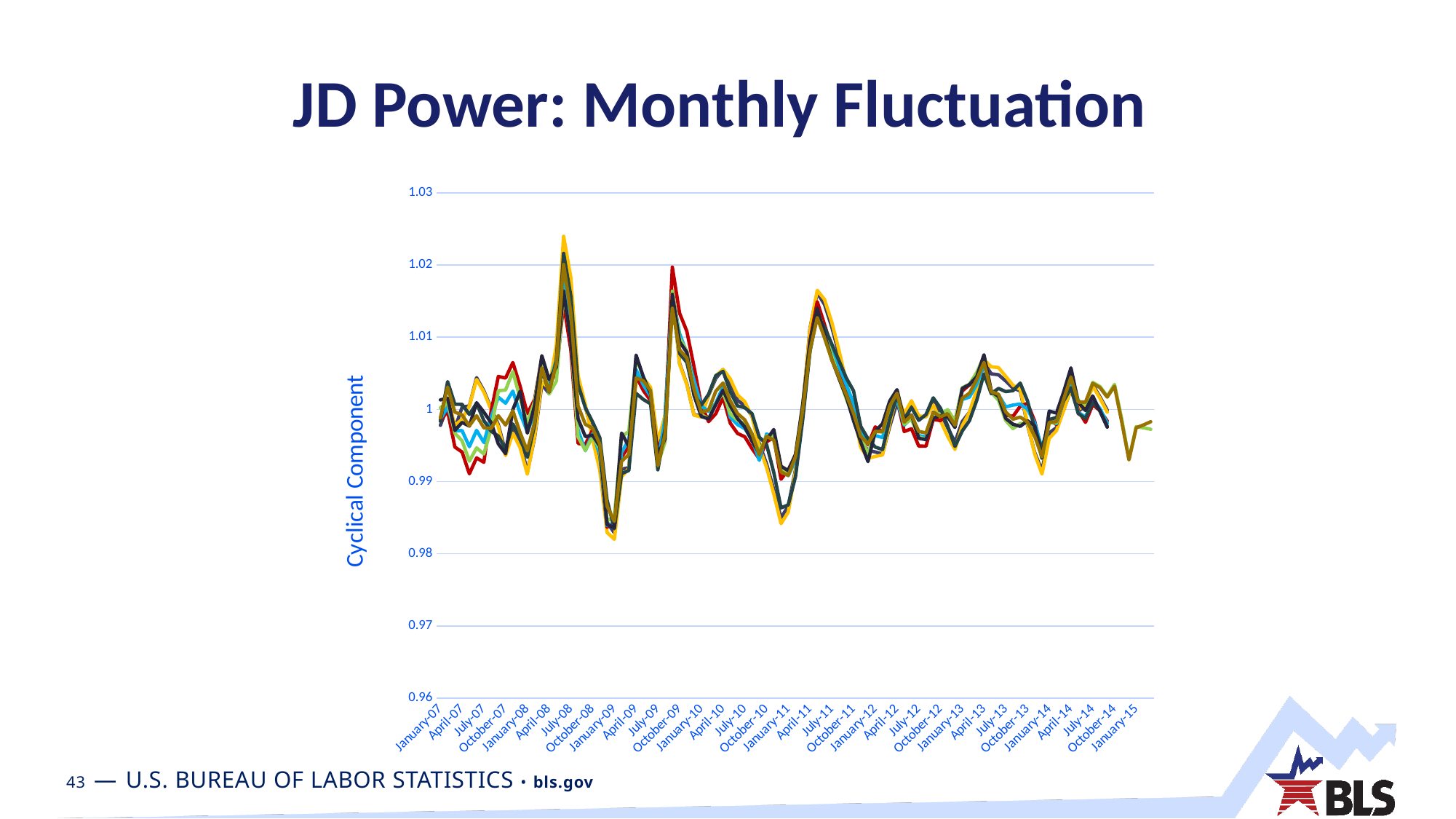
What is the first label on the horizontal axis? January-07 Is the highest value plotted around July-11 greater or less than 1.01? greater What is the title of the chart on the slide? JD Power: Monthly Fluctuation How many tick labels are shown on the vertical axis? 8 What kind of chart is shown on the slide? line chart What is the highest value shown on the vertical axis? 1.03 What is the lowest value shown on the vertical axis? 0.96 Is the lowest value plotted around January-09 greater or less than 0.99? less Is the lowest value plotted around January-11 greater or less than 0.99? less What is the label of the vertical axis? Cyclical Component What is the last label on the horizontal axis? January-15